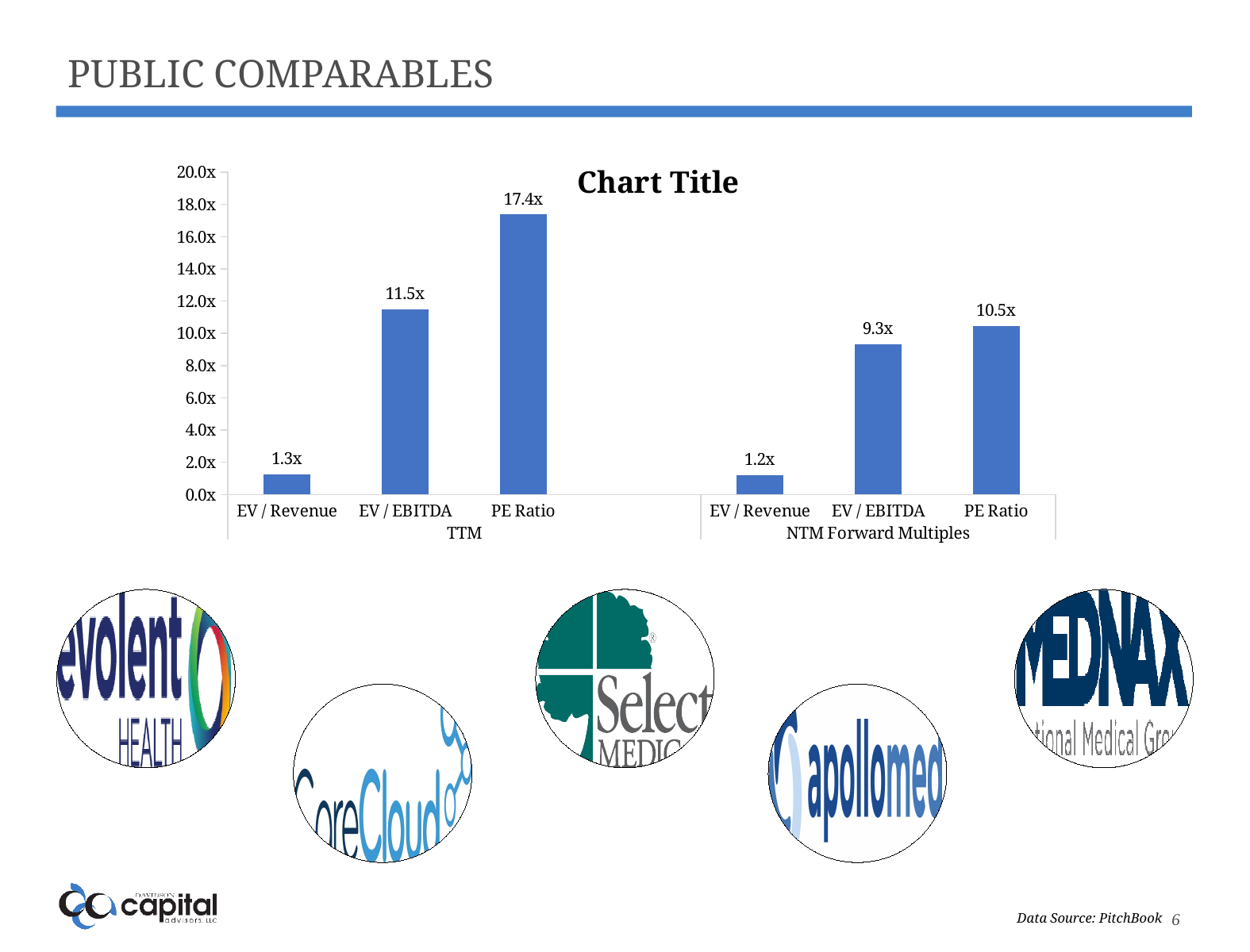
What type of chart is shown on the slide? Bar chart What are the two group labels shown beneath the x axis of the chart? TTM and NTM Forward Multiples Which is larger, the TTM EV / EBITDA multiple or the NTM Forward PE Ratio? TTM EV / EBITDA What is the NTM Forward EV / EBITDA multiple shown on the chart? 9.3x Which bar on the chart has the highest value? TTM PE Ratio What is the NTM Forward PE Ratio shown on the chart? 10.5x What is the difference between the TTM EV / EBITDA and the NTM Forward EV / EBITDA multiples? 2.2x How many bars are plotted on the chart? 6 What is the TTM EV / Revenue multiple shown on the chart? 1.3x Which bar on the chart has the lowest value? NTM Forward Multiples EV / Revenue What is the TTM EV / EBITDA multiple shown on the chart? 11.5x What is the difference between the TTM PE Ratio and the NTM Forward PE Ratio? 6.9x